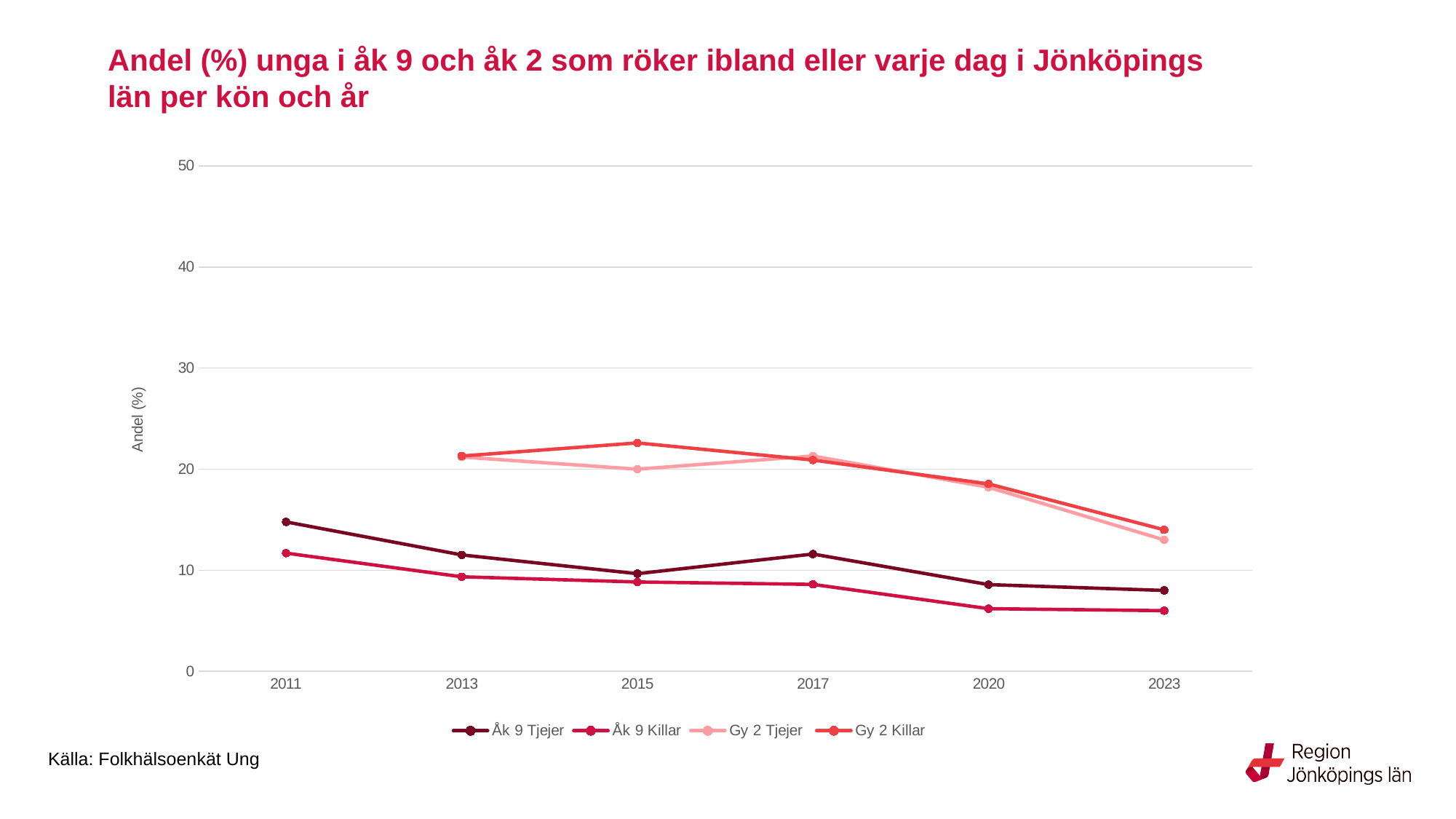
Is the value for Åk 9 Killar in 2023 greater or less than 10? less Is the value for Gy 2 Killar in 2015 greater or less than 20? greater How many years are shown on the x axis? 6 What kind of chart is shown on the slide? line chart How many series does the legend list? 4 Which series has the highest value in 2015? Gy 2 Killar What is the label of the y axis? Andel (%) In 2011, which is larger: Åk 9 Tjejer or Åk 9 Killar? Åk 9 Tjejer Is the value for Gy 2 Tjejer in 2023 greater or less than 10? greater Does the Åk 9 Killar series rise or fall from 2011 to 2023? fall Which series has the lowest value in 2023? Åk 9 Killar